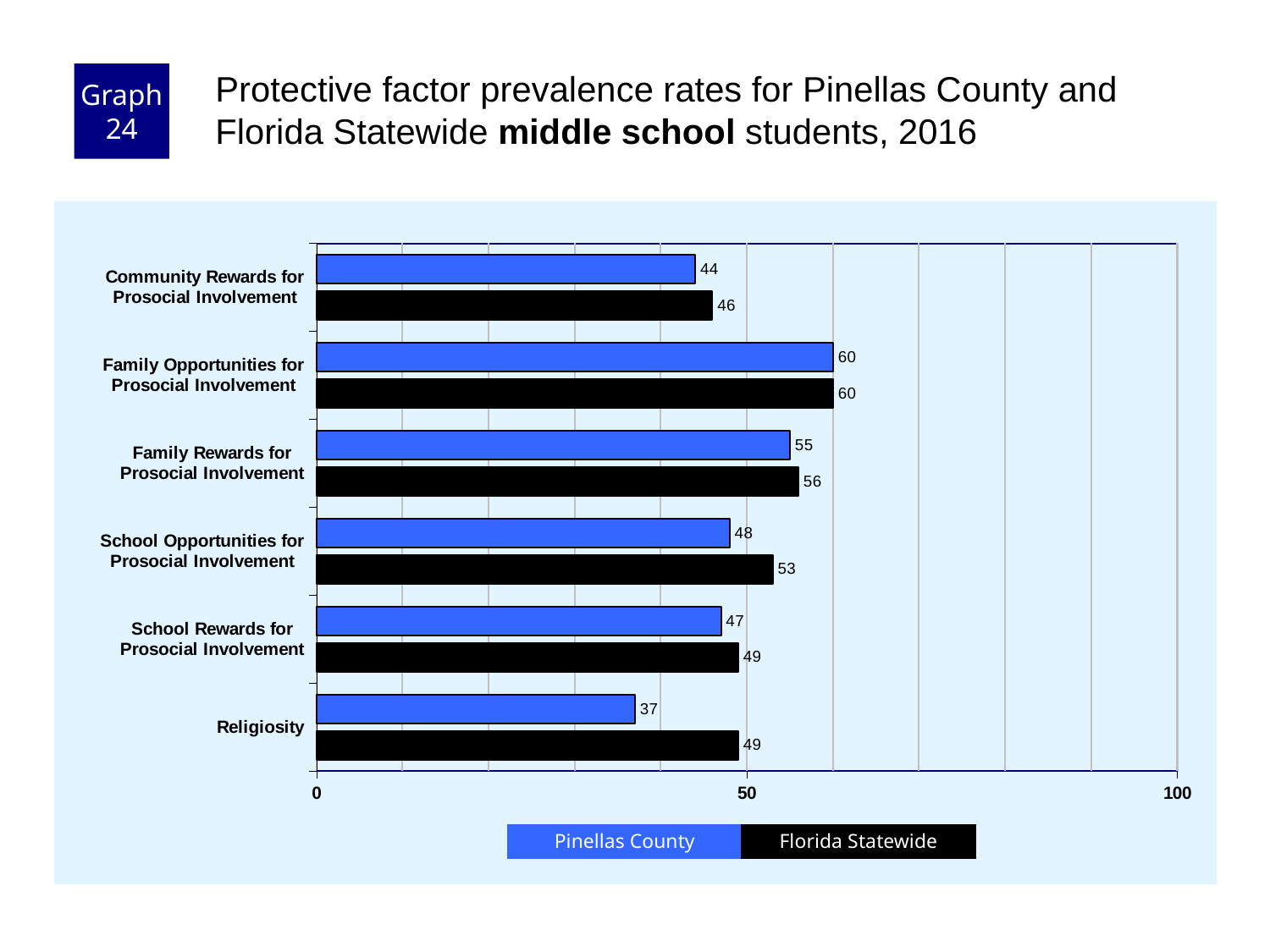
What kind of chart is shown on the slide? bar chart How many protective factors are shown on the chart? 6 Which protective factor has the highest Pinellas County value? Family Opportunities for Prosocial Involvement Which colour represents Florida Statewide in the legend? black What is the Florida Statewide value for School Opportunities for Prosocial Involvement? 53 What is the difference between the Florida Statewide and Pinellas County values for Religiosity? 12 What is the difference between the Florida Statewide and Pinellas County values for School Opportunities for Prosocial Involvement? 5 What is the Pinellas County value for Religiosity? 37 What is the Pinellas County value for Family Rewards for Prosocial Involvement? 55 How many series does the legend list? 2 Which is larger for Community Rewards for Prosocial Involvement: the Pinellas County value or the Florida Statewide value? Florida Statewide Which protective factor has the lowest Pinellas County value? Religiosity